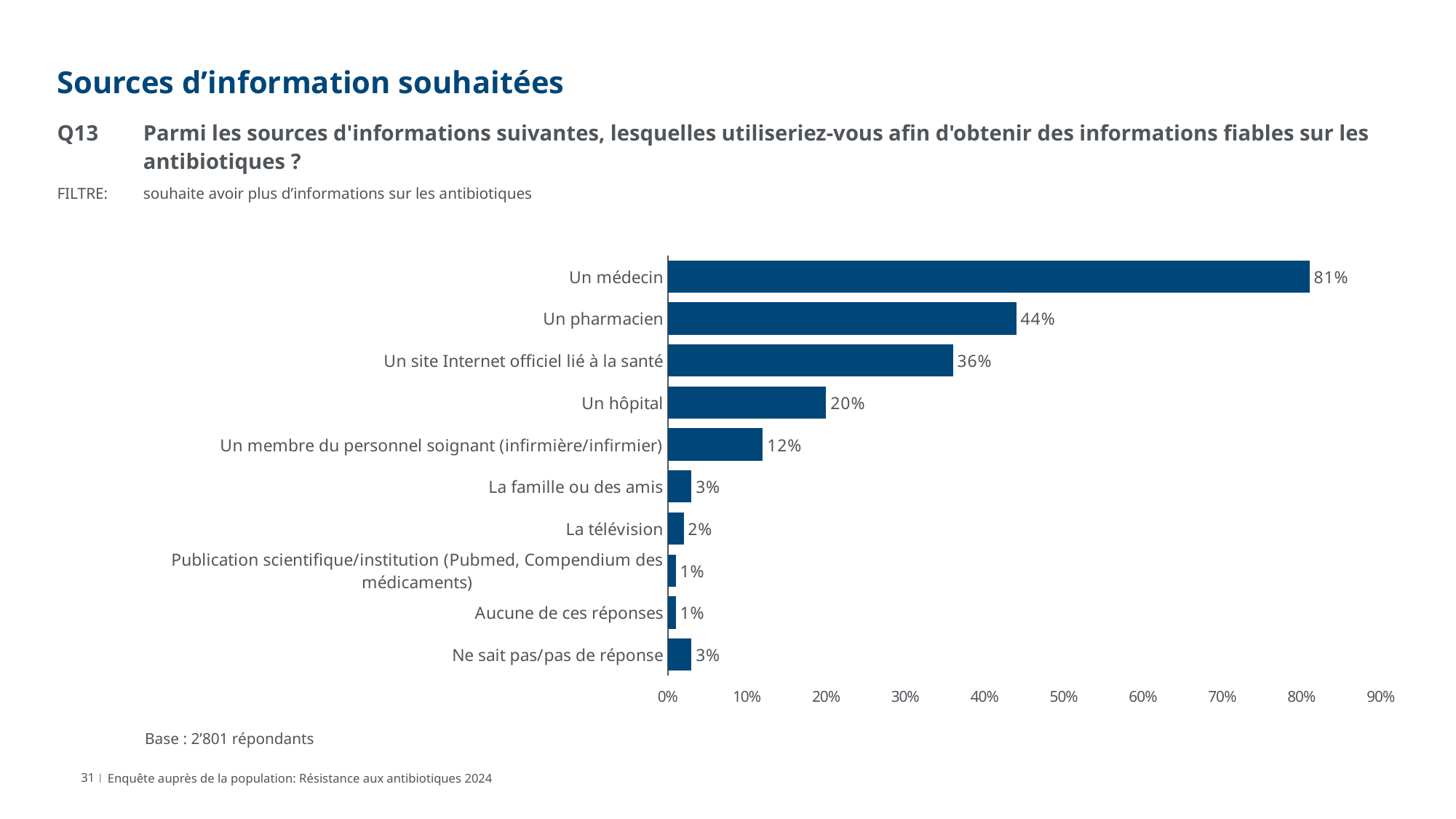
What is the value shown for 'Un membre du personnel soignant (infirmière/infirmier)'? 12% What percentage of respondents would use 'Un médecin' to obtain reliable information on antibiotics? 81% What is the difference between the values for 'Un médecin' and 'Un pharmacien'? 37% What is the base (number of respondents) stated below the chart? 2’801 répondants How many categories are shown in the chart? 10 What is the value shown for 'Un pharmacien'? 44% Is the value for 'Un pharmacien' greater or less than 40%? greater What is the value shown for 'Un site Internet officiel lié à la santé'? 36% Which source has the highest value in the chart? Un médecin What kind of chart is shown on the slide? Bar chart What is the difference between the values for 'Un hôpital' and 'La télévision'? 18% Which is larger, the value for 'Un hôpital' or the value for 'Un site Internet officiel lié à la santé'? Un site Internet officiel lié à la santé